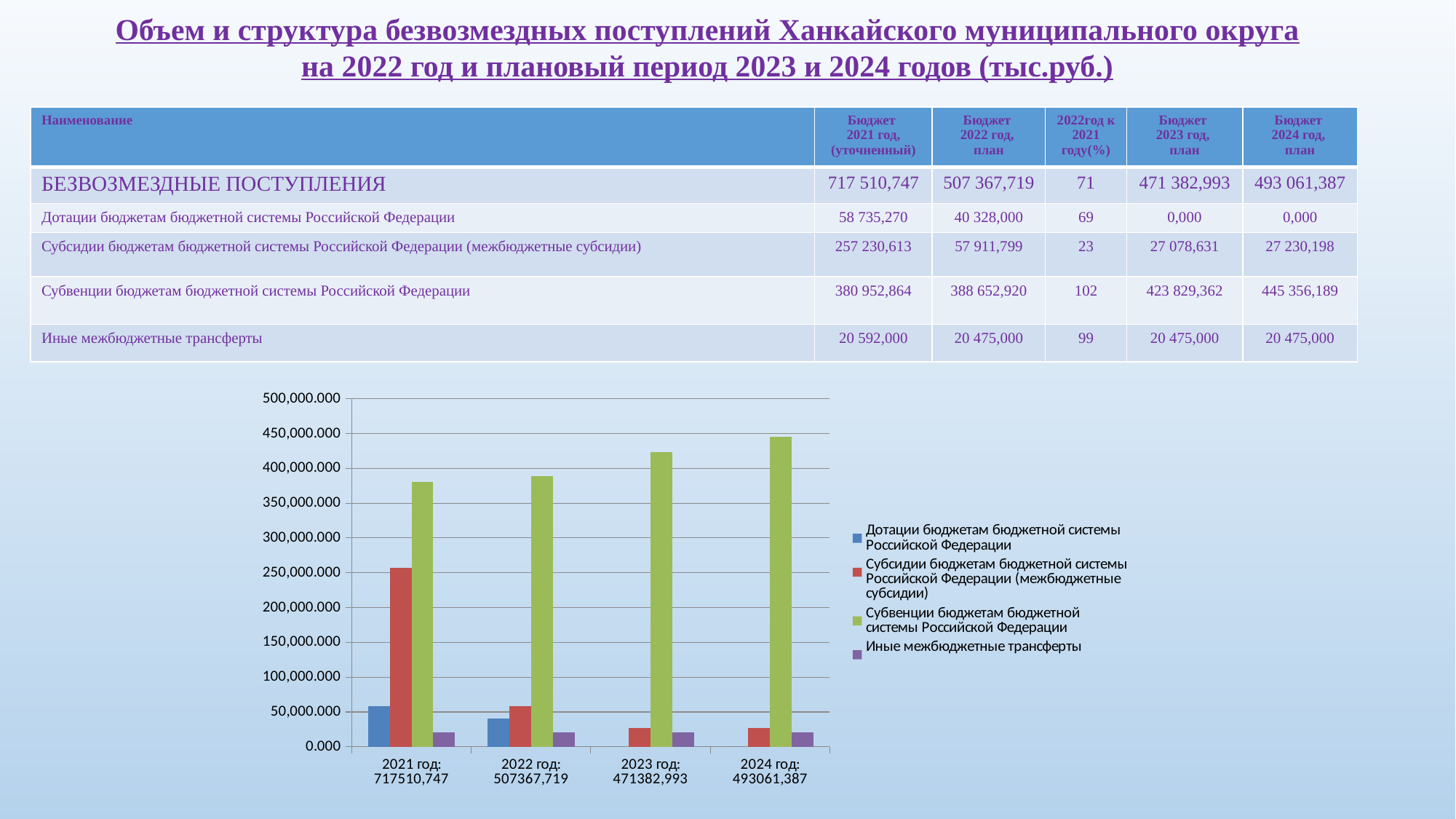
Is the value for Субвенции бюджетам бюджетной системы Российской Федерации in 2024 год greater or less than 400,000.000? greater What total is printed in the x-axis label for 2022 год? 507367,719 In which year is the bar for Субвенции бюджетам бюджетной системы Российской Федерации the highest? 2024 год In 2021 год, which is larger: the bar for Субсидии бюджетам бюджетной системы Российской Федерации (межбюджетные субсидии) or the bar for Субвенции бюджетам бюджетной системы Российской Федерации? Субвенции бюджетам бюджетной системы Российской Федерации Is the value for Дотации бюджетам бюджетной системы Российской Федерации in 2021 год greater or less than 100,000.000? less How many year categories are shown on the x axis of the chart? 4 How many series does the chart legend list? 4 What kind of chart is shown on the slide? bar chart Do the bars for Субсидии бюджетам бюджетной системы Российской Федерации (межбюджетные субсидии) rise or fall from 2021 год to 2022 год? fall What colour are the bars for Субвенции бюджетам бюджетной системы Российской Федерации in the chart? green Is the value for Субсидии бюджетам бюджетной системы Российской Федерации (межбюджетные субсидии) in 2021 год greater or less than 200,000.000? greater Do the bars for Субвенции бюджетам бюджетной системы Российской Федерации rise or fall from 2021 год to 2024 год? rise